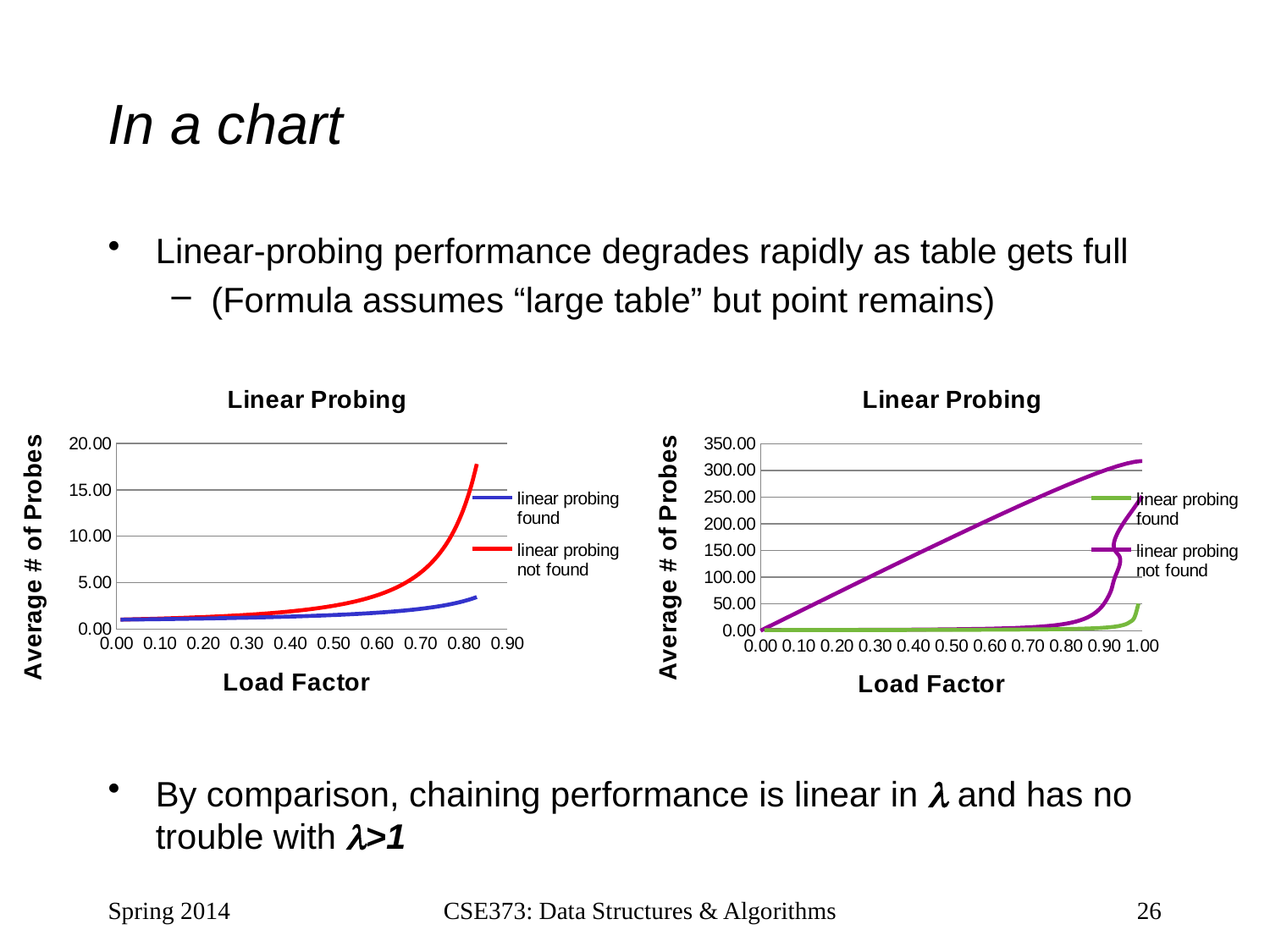
In the left chart, is the value of "linear probing found" at load factor 0.80 greater or less than 5.00? less How many series does the legend of the right chart list? 2 What is the y-axis label of the right chart? Average # of Probes How many series does the legend of the left chart list? 2 In the left chart, which series has the higher value at load factor 0.80, "linear probing found" or "linear probing not found"? linear probing not found In the left chart, does the "linear probing not found" series rise or fall as the load factor increases? rise In the right chart, does the "linear probing not found" series rise or fall as the load factor increases? rise What kind of chart is the left chart titled "Linear Probing"? line chart In the left chart, is the value of "linear probing not found" at load factor 0.80 greater or less than 5.00? greater What is the x-axis label of the left chart? Load Factor